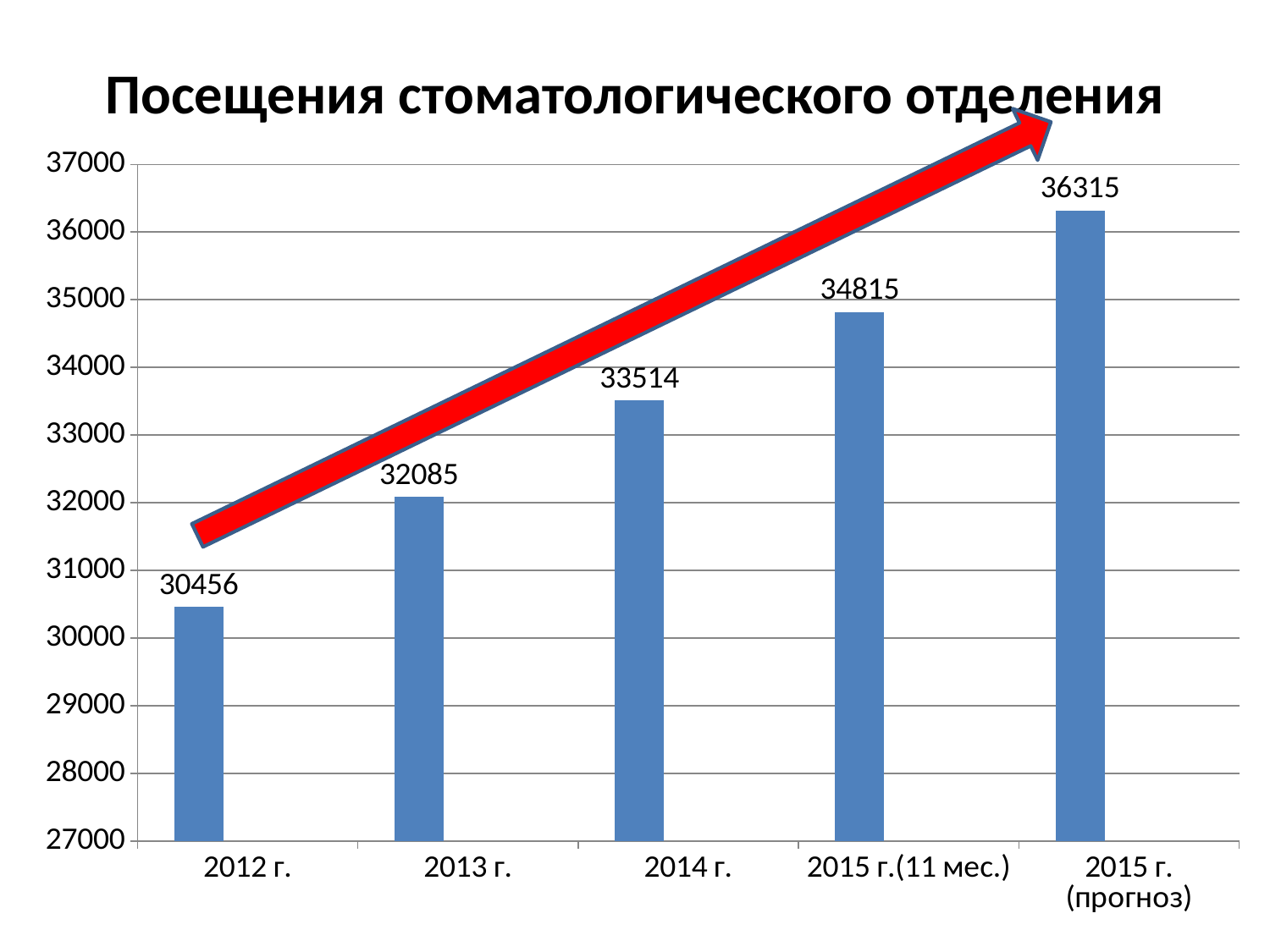
What is the value for 2015 г.(11 мес.)? 34815 Which category has the lowest value? 2012 г. Which category has the highest value? 2015 г. (прогноз) Is the value for 2015 г.(11 мес.) greater or less than 34000? greater Which is larger, the value for 2013 г. or the value for 2014 г.? 2014 г. Do the values rise or fall from 2012 г. to 2015 г. (прогноз)? rise What kind of chart is this? bar chart How many categories are shown on the x axis? 5 What is the value for 2012 г.? 30456 What is the value for 2014 г.? 33514 What is the difference between the values for 2015 г. (прогноз) and 2012 г.? 5859 What is the difference between the values for 2013 г. and 2012 г.? 1629